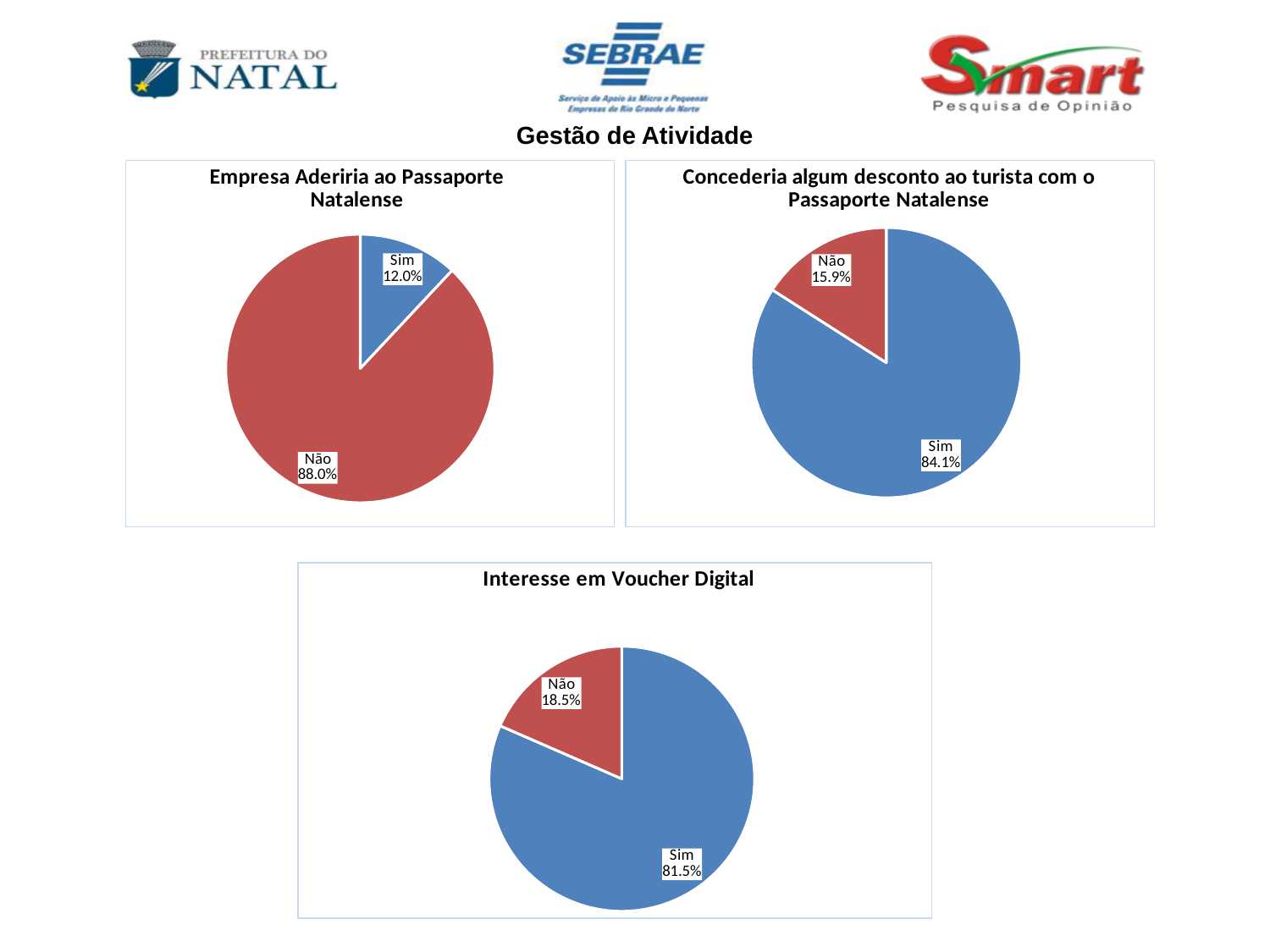
How many slices does the 'Empresa Aderiria ao Passaporte Natalense' chart have? 2 In the 'Concederia algum desconto ao turista com o Passaporte Natalense' chart, what is the value for Sim? 84.1% In the 'Concederia algum desconto ao turista com o Passaporte Natalense' chart, what is the difference between Sim and Não? 68.2% What kind of chart is the 'Interesse em Voucher Digital' chart? Pie chart In the 'Interesse em Voucher Digital' chart, what is the value for Sim? 81.5% In the 'Interesse em Voucher Digital' chart, what is the value for Não? 18.5% In the 'Empresa Aderiria ao Passaporte Natalense' chart, which slice is the largest? Não In the 'Interesse em Voucher Digital' chart, which slice is the smallest? Não In the 'Empresa Aderiria ao Passaporte Natalense' chart, what is the value for Não? 88.0% In the 'Interesse em Voucher Digital' chart, which is larger, Sim or Não? Sim In the 'Concederia algum desconto ao turista com o Passaporte Natalense' chart, what is the value for Não? 15.9% In the 'Empresa Aderiria ao Passaporte Natalense' chart, what is the value for Sim? 12.0%